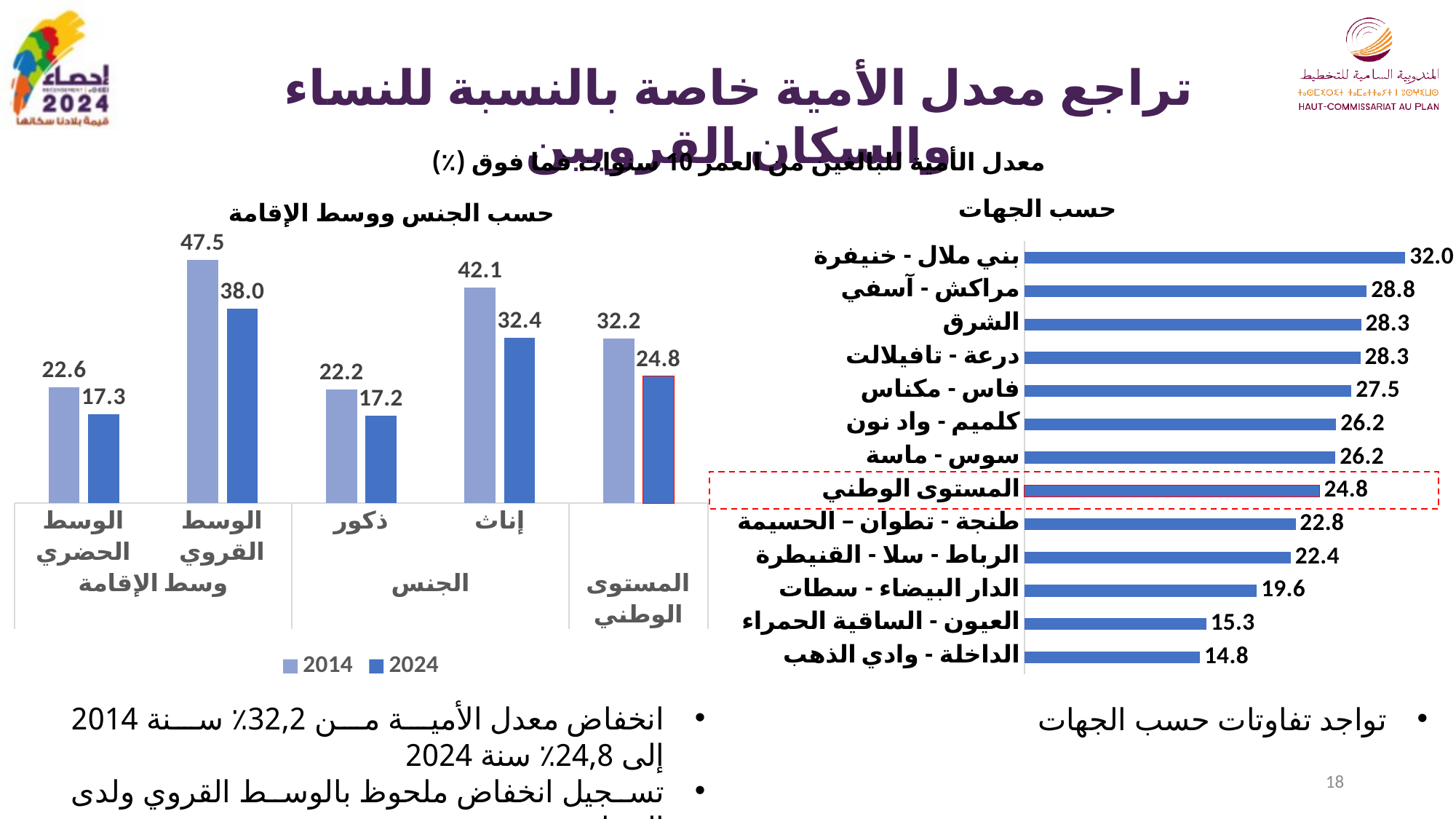
What type of chart is the one titled 'حسب الجهات'? bar chart In the chart titled 'حسب الجهات', which region has the highest value? بني ملال - خنيفرة In the chart titled 'حسب الجنس ووسط الإقامة', which category has the highest 2014 value? الوسط القروي In the chart titled 'حسب الجنس ووسط الإقامة', how many series does the legend list? 2 In the chart titled 'حسب الجنس ووسط الإقامة', what is the 2014 value for إناث? 42.1 In the chart titled 'حسب الجهات', what is the difference between بني ملال - خنيفرة and الدار البيضاء - سطات? 12.4 In the chart titled 'حسب الجهات', what is the value for فاس - مكناس? 27.5 In the chart titled 'حسب الجنس ووسط الإقامة', what is the 2024 value for الوسط القروي? 38.0 In the chart titled 'حسب الجنس ووسط الإقامة', what is the difference between the 2014 and 2024 values for المستوى الوطني? 7.4 In the chart titled 'حسب الجنس ووسط الإقامة', which is larger: the 2024 value for ذكور or the 2024 value for الوسط الحضري? الوسط الحضري In the chart titled 'حسب الجهات', how many bars are plotted? 13 In the chart titled 'حسب الجهات', which region has the lowest value? الداخلة - وادي الذهب